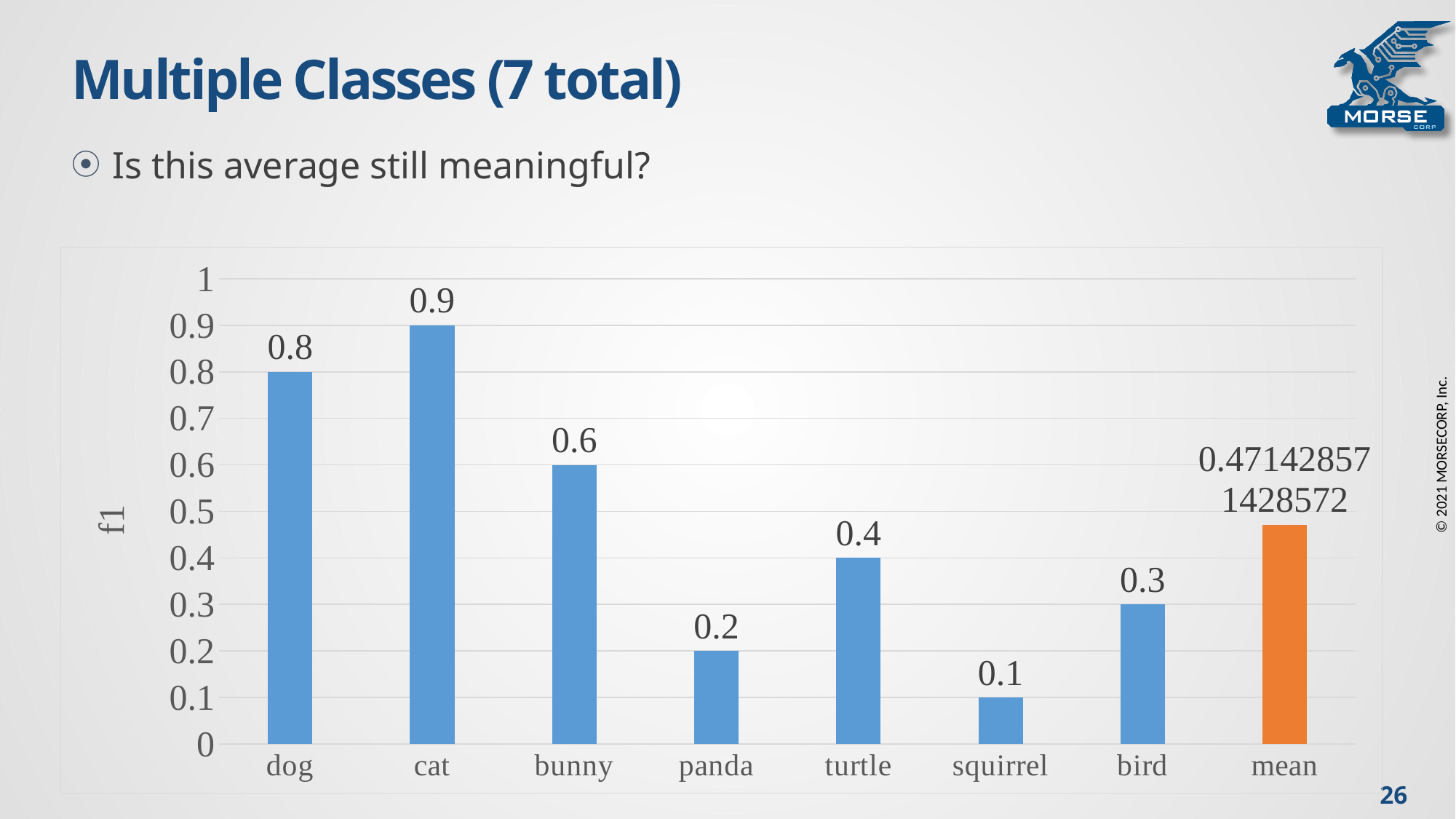
Which category has the highest f1 value? cat Which category has the lowest f1 value? squirrel What is the difference between the f1 values for dog and bunny? 0.2 What is the label on the vertical axis? f1 Which bar is coloured orange instead of blue? mean Is the value for the mean bar greater or less than 0.5? less What value is labelled on the mean bar? 0.471428571428572 What is the f1 value for squirrel? 0.1 What kind of chart is shown on the slide? bar chart What is the f1 value for cat? 0.9 How many bars are shown in the chart? 8 Which has a larger f1 value, turtle or bird? turtle